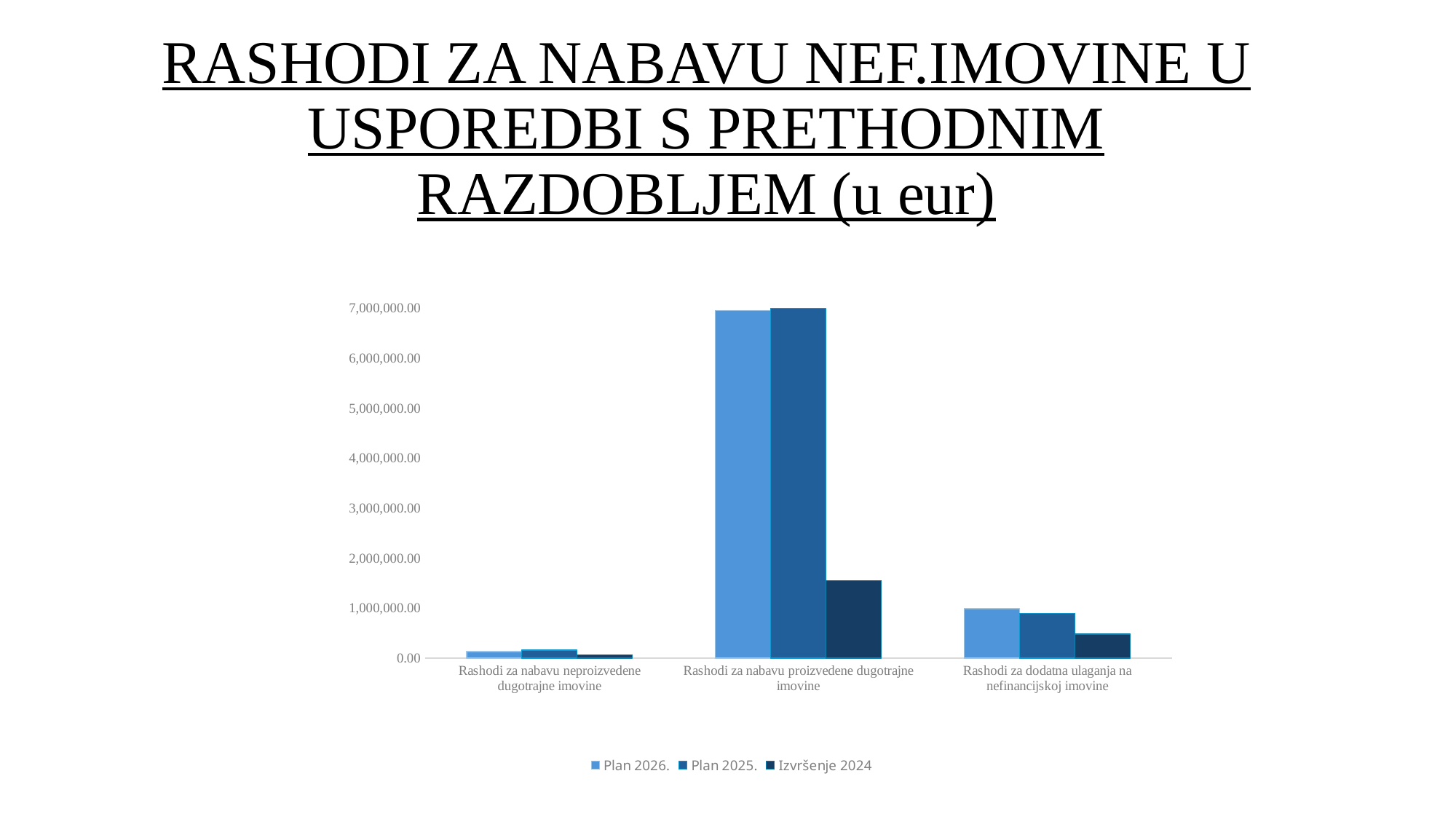
Is the Plan 2026. value for Rashodi za nabavu proizvedene dugotrajne imovine greater or less than 6,000,000.00? greater For Rashodi za dodatna ulaganja na nefinancijskoj imovini, which is larger: Plan 2025. or Izvršenje 2024? Plan 2025. How many categories are shown on the x axis? 3 How many series does the legend list? 3 Is the Izvršenje 2024 value for Rashodi za nabavu proizvedene dugotrajne imovine greater or less than 2,000,000.00? less What kind of chart is shown on the slide? bar chart Which category has the highest Plan 2026. value? Rashodi za nabavu proizvedene dugotrajne imovine Is the Izvršenje 2024 value for Rashodi za dodatna ulaganja na nefinancijskoj imovini greater or less than 1,000,000.00? less Which series is shown in the darkest blue in the legend? Izvršenje 2024 Which category has the lowest Izvršenje 2024 value? Rashodi za nabavu neproizvedene dugotrajne imovine For Rashodi za nabavu proizvedene dugotrajne imovine, which is larger: Plan 2026. or Izvršenje 2024? Plan 2026.